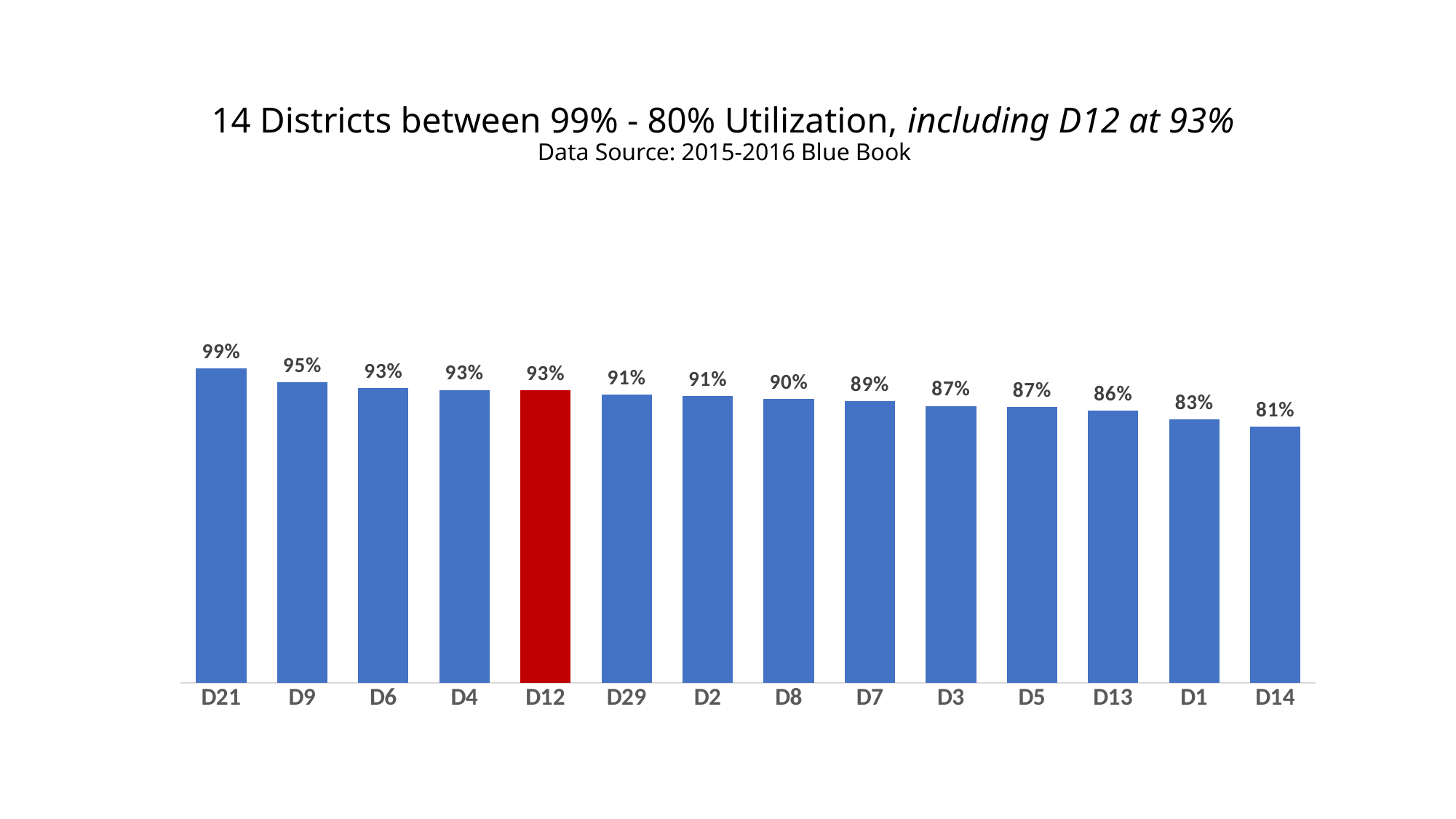
What is the utilization value for D12? 93% What is the difference between the utilization of D21 and D14? 18% What is the utilization value for D8? 90% Which district has the lowest utilization? D14 What is the difference between the utilization of D9 and D13? 9% Which has a higher utilization, D29 or D7? D29 Do the values rise or fall from left to right along the x axis? Fall Which district has the highest utilization? D21 What kind of chart is shown on the slide? Bar chart What is the utilization value for D1? 83% Which district's bar is coloured red instead of blue? D12 How many districts are shown in the chart? 14